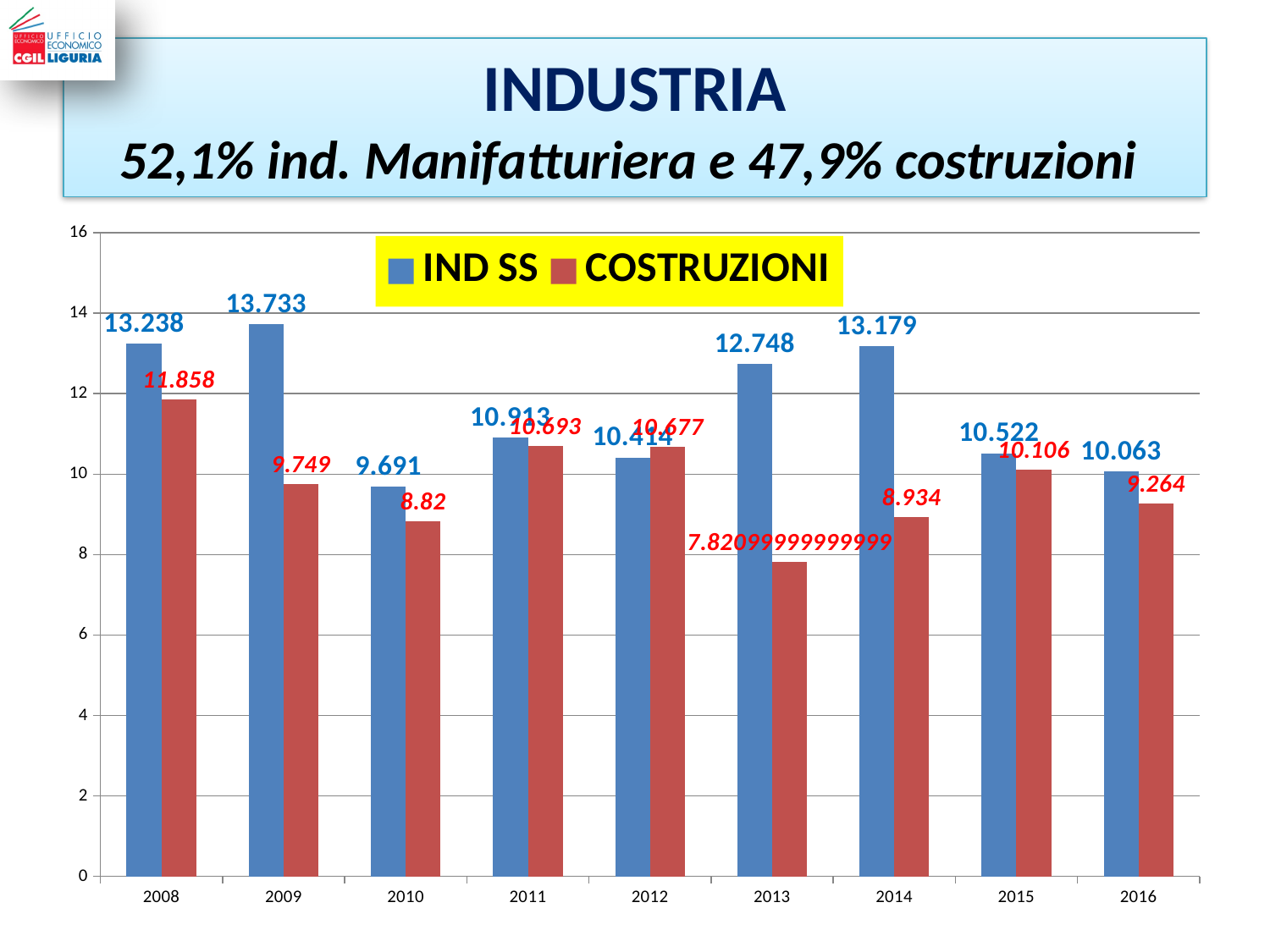
In 2014, which series has the larger value, IND SS or COSTRUZIONI? IND SS Is the COSTRUZIONI value for 2013 greater or less than 8? less How many series does the legend list? 2 In which year is the IND SS value lowest? 2010 In which year is the COSTRUZIONI value lowest? 2013 How many years are shown on the x axis? 9 In which year is the IND SS value highest? 2009 What is the value of COSTRUZIONI in 2008? 11.858 In which year is the COSTRUZIONI value highest? 2008 What is the value of IND SS in 2009? 13.733 What is the value of COSTRUZIONI in 2016? 9.264 What is the difference between the IND SS values for 2009 and 2008? 0.495